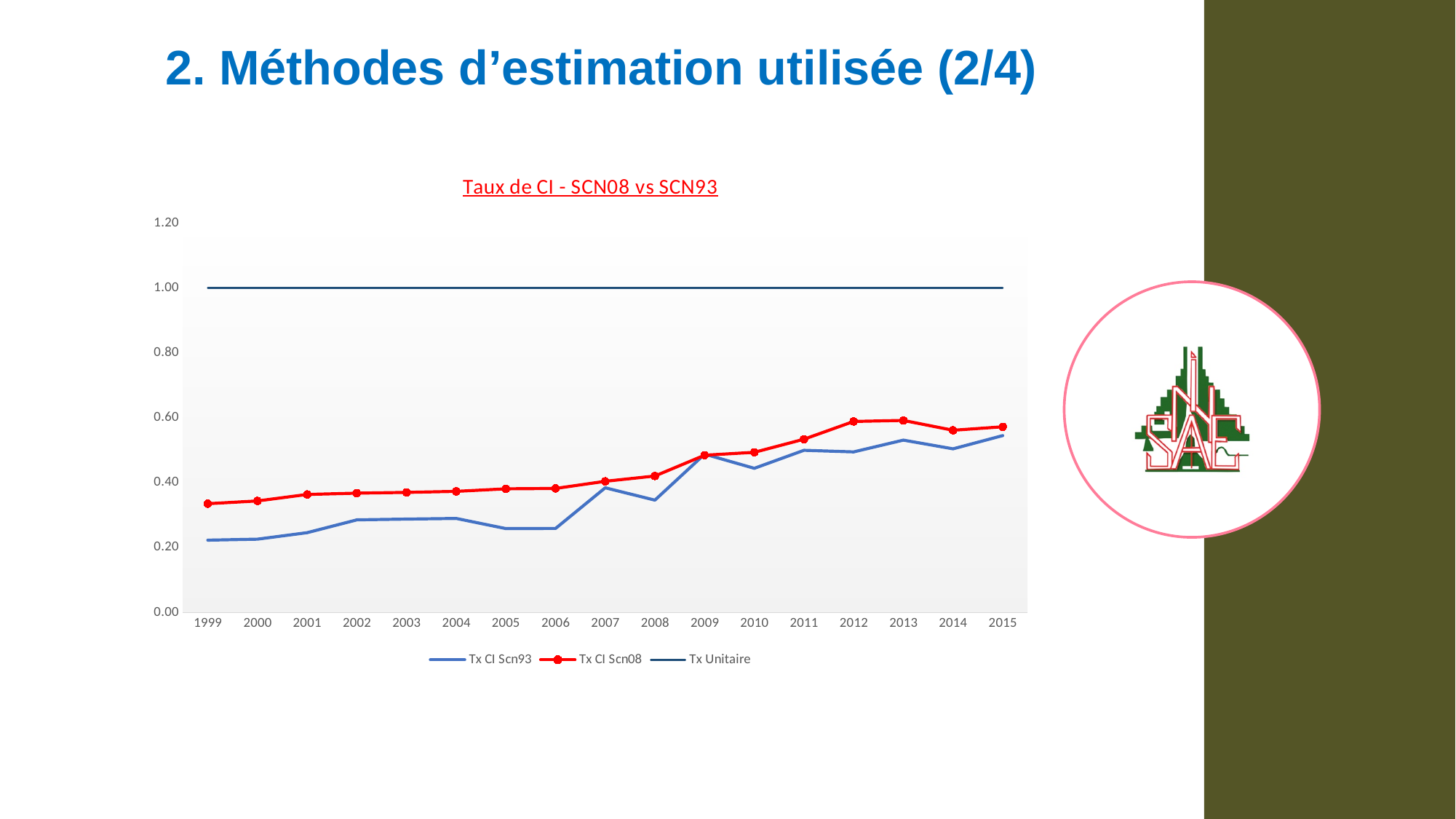
Which series is drawn in red with circular markers? Tx CI Scn08 Is the value for Tx CI Scn08 in 1999 greater or less than 0.40? less What type of chart is shown on the slide? Line chart Is the value for Tx CI Scn93 in 2006 greater or less than 0.40? less What is the title of the chart? Taux de CI - SCN08 vs SCN93 How many series does the legend list? 3 Is the value for Tx CI Scn93 in 2015 greater or less than 0.40? greater In 2008, which series has the larger value, Tx CI Scn08 or Tx CI Scn93? Tx CI Scn08 What is the value of the Tx Unitaire series in 2005? 1.00 Does the Tx CI Scn93 series generally rise or fall from 1999 to 2015? Rise How many years are shown on the x axis? 17